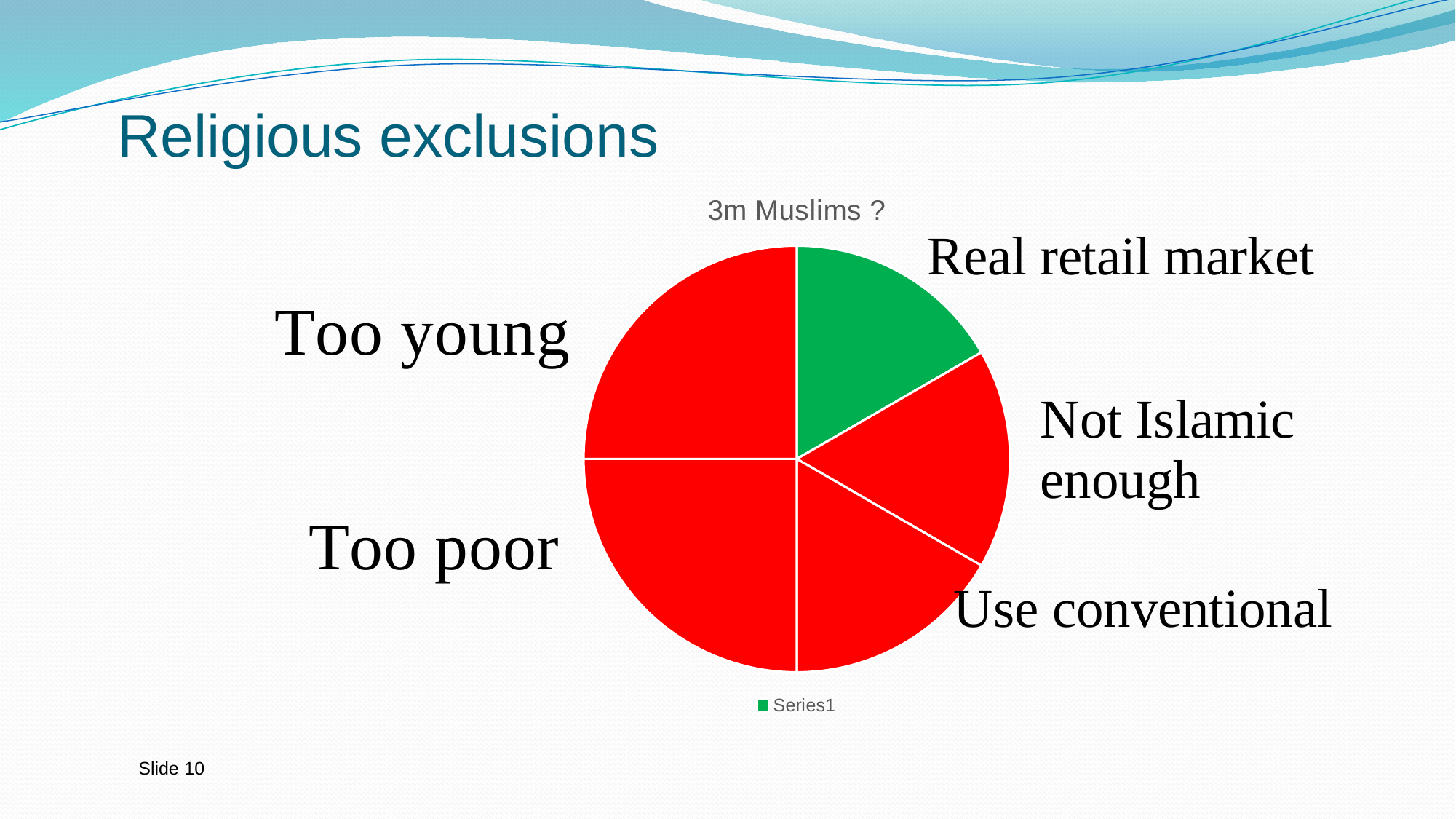
How many series does the legend of the pie chart list? 1 Which slice of the pie chart is coloured green? Real retail market Which slice is larger, Too poor or Real retail market? Too poor What kind of chart is shown on the slide? pie chart What is the title of the pie chart? 3m Muslims ? Which slice is larger, Too young or Use conventional? Too young How many slices does the pie chart have? 5 Which slice is larger, Too poor or Not Islamic enough? Too poor